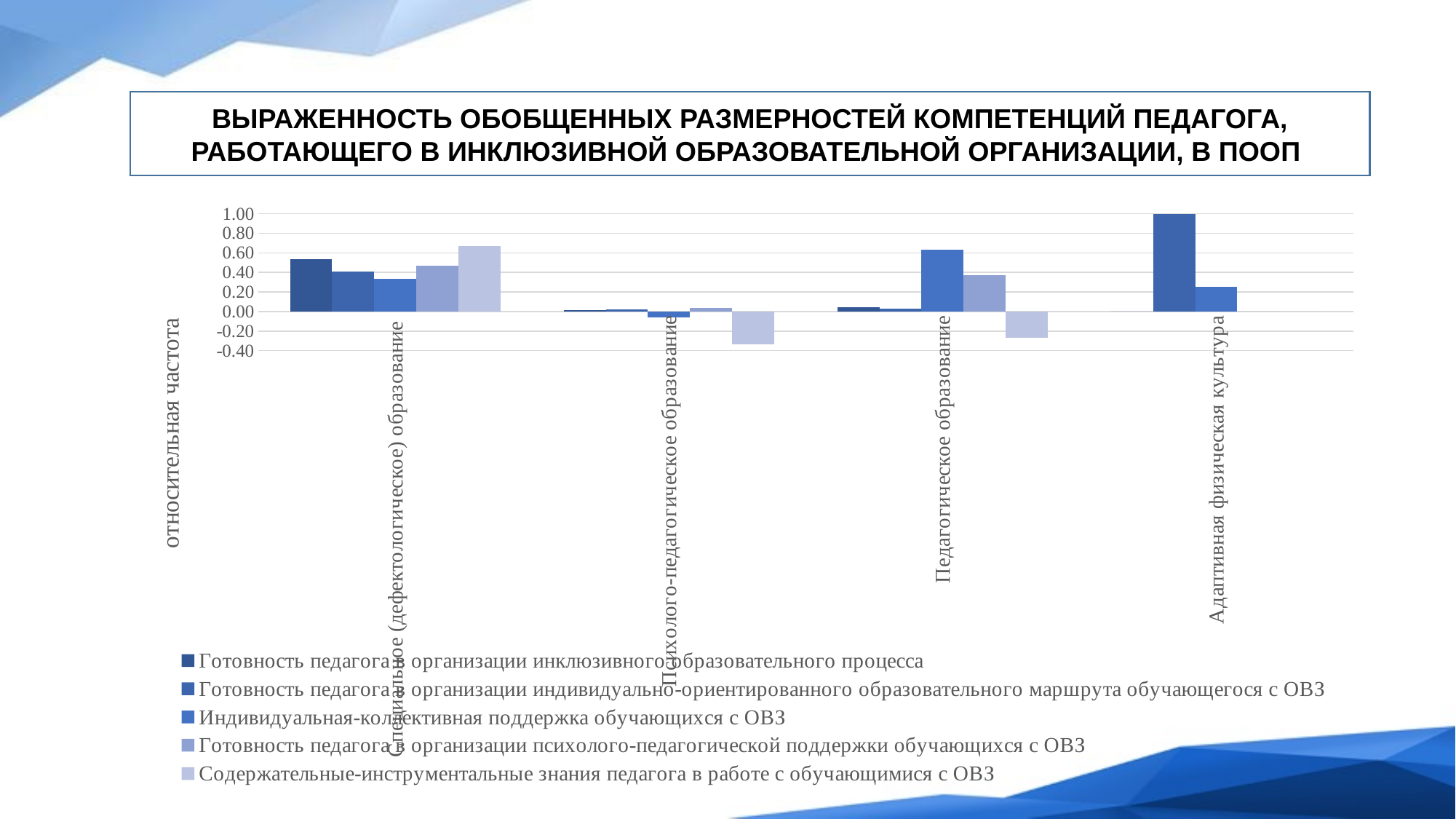
In the category Специальное (дефектологическое) образование, which is larger: Содержательные-инструментальные знания педагога в работе с обучающимися с ОВЗ or Индивидуальная-коллективная поддержка обучающихся с ОВЗ? Содержательные-инструментальные знания педагога в работе с обучающимися с ОВЗ Is the value for Индивидуальная-коллективная поддержка обучающихся с ОВЗ in the category Педагогическое образование greater or less than 0.40? greater How many categories are shown along the x axis of the chart? 4 Is the value for Содержательные-инструментальные знания педагога в работе с обучающимися с ОВЗ in the category Специальное (дефектологическое) образование greater or less than 0.40? greater What is the title of the chart's vertical axis? относительная частота How many series does the chart's legend list? 5 Which category contains the tallest bar in the chart? Адаптивная физическая культура What kind of chart is shown on the slide? bar chart Is the value for Содержательные-инструментальные знания педагога в работе с обучающимися с ОВЗ in the category Психолого-педагогическое образование greater or less than -0.20? less In the category Педагогическое образование, which series has the lowest value? Содержательные-инструментальные знания педагога в работе с обучающимися с ОВЗ In the category Педагогическое образование, which series has the highest value? Индивидуальная-коллективная поддержка обучающихся с ОВЗ